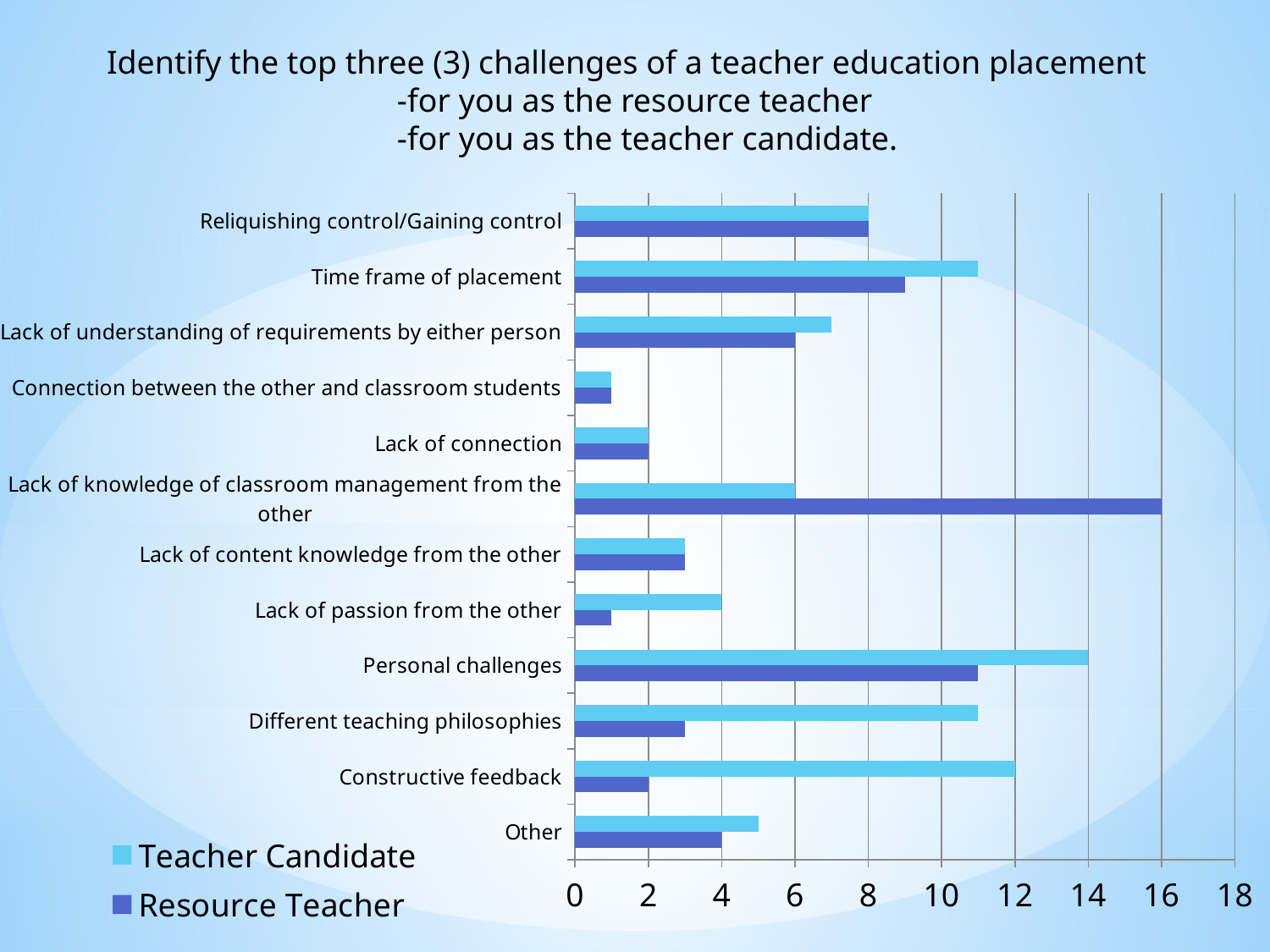
What is the Resource Teacher value for 'Reliquishing control/Gaining control'? 8 What is the Resource Teacher value for 'Lack of knowledge of classroom management from the other'? 16 How many challenge categories are plotted on the chart? 12 Which category has the highest Resource Teacher value? Lack of knowledge of classroom management from the other What is the Teacher Candidate value for 'Constructive feedback'? 12 Is the Teacher Candidate value for 'Time frame of placement' greater or less than 10? greater What kind of chart is shown on the slide? bar chart How many series does the legend list? 2 For 'Different teaching philosophies', which series has the larger value, Teacher Candidate or Resource Teacher? Teacher Candidate What is the Teacher Candidate value for 'Personal challenges'? 14 Which category has the highest Teacher Candidate value? Personal challenges What is the difference between the Resource Teacher and Teacher Candidate values for 'Lack of knowledge of classroom management from the other'? 10